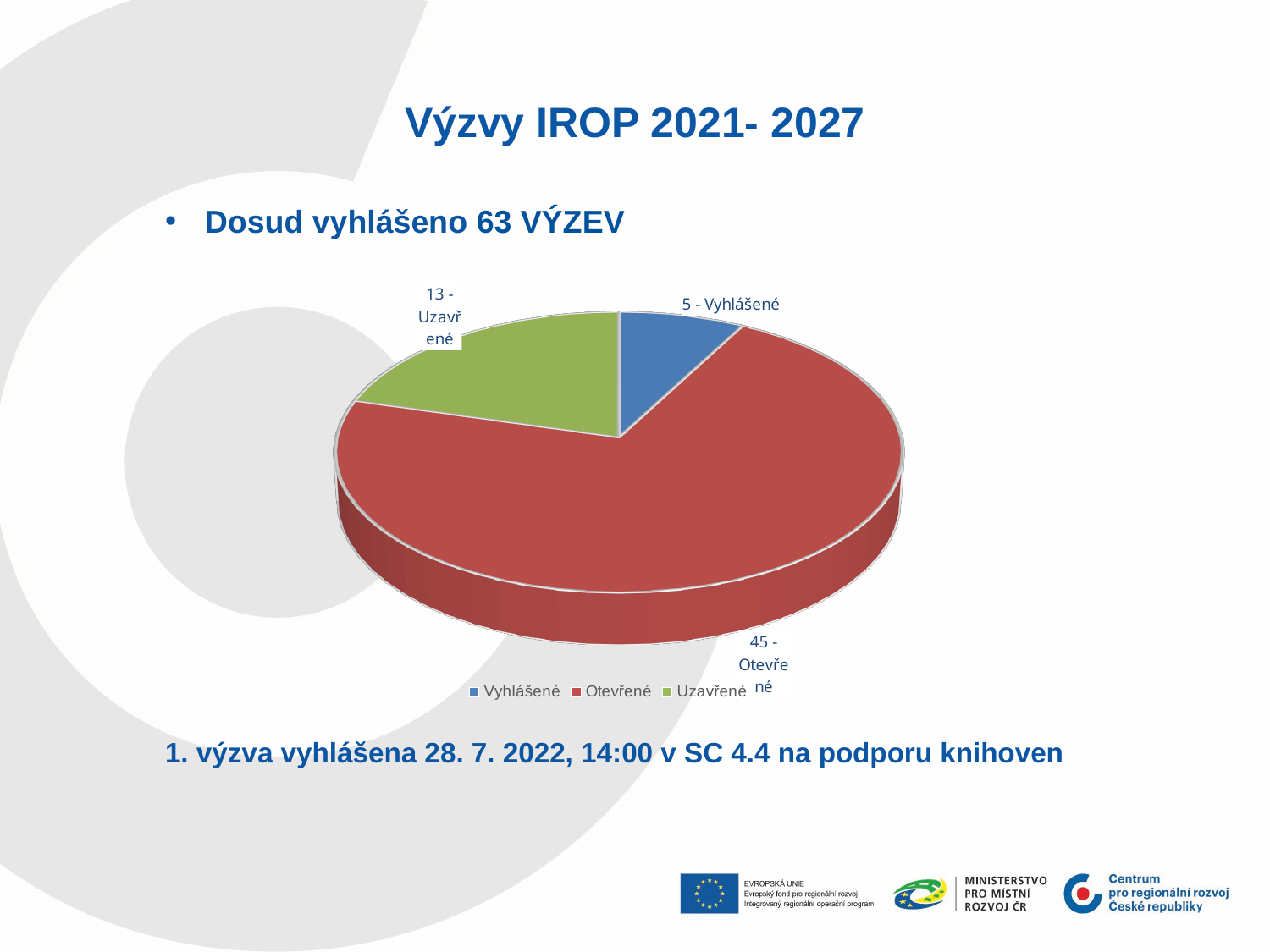
Which colour represents Otevřené in the pie chart? red How many entries does the legend of the pie chart list? 3 What is the value for Otevřené in the pie chart? 45 What is the total of all slices in the pie chart? 63 Which category has the largest slice in the pie chart? Otevřené What is the value for Uzavřené in the pie chart? 13 What is the value for Vyhlášené in the pie chart? 5 Which category has the smallest slice in the pie chart? Vyhlášené What is the difference between the values for Otevřené and Uzavřené? 32 How many slices does the pie chart have? 3 Which is larger, the value for Uzavřené or the value for Vyhlášené? Uzavřené What kind of chart is shown on the slide? pie chart